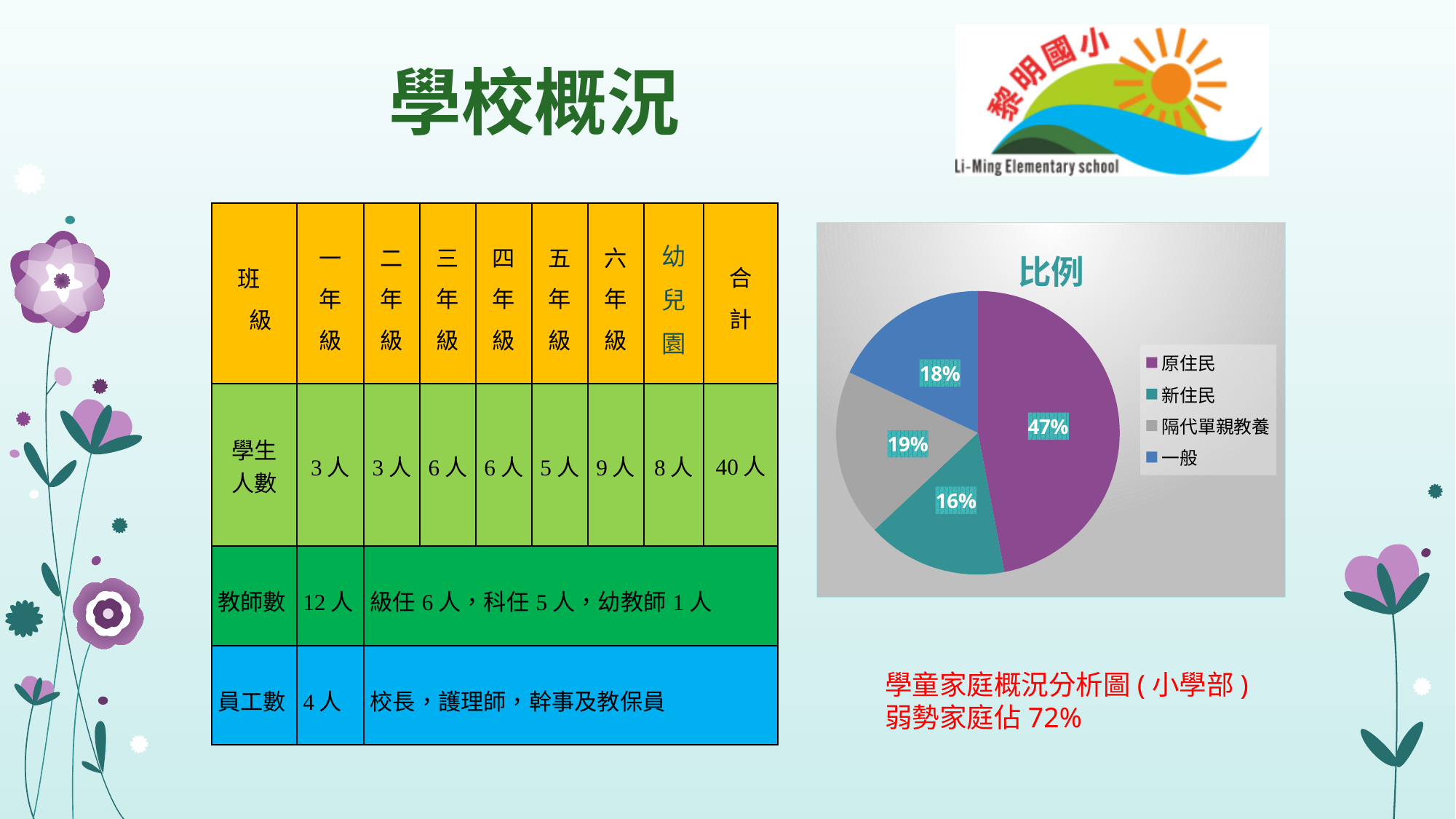
What percentage of the pie chart is 新住民? 16% What kind of chart is shown on the slide? pie chart What percentage of the pie chart is 一般? 18% Which is larger in the pie chart, 隔代單親教養 or 新住民? 隔代單親教養 What percentage of the pie chart is 原住民? 47% Which category has the smallest share of the pie chart? 新住民 What is the title of the pie chart? 比例 What is the difference in percentage points between 原住民 and 隔代單親教養 in the pie chart? 28 What percentage of the pie chart is 隔代單親教養? 19% What colour is the 原住民 slice in the pie chart? purple Which category has the largest share of the pie chart? 原住民 How many categories does the pie chart's legend list? 4